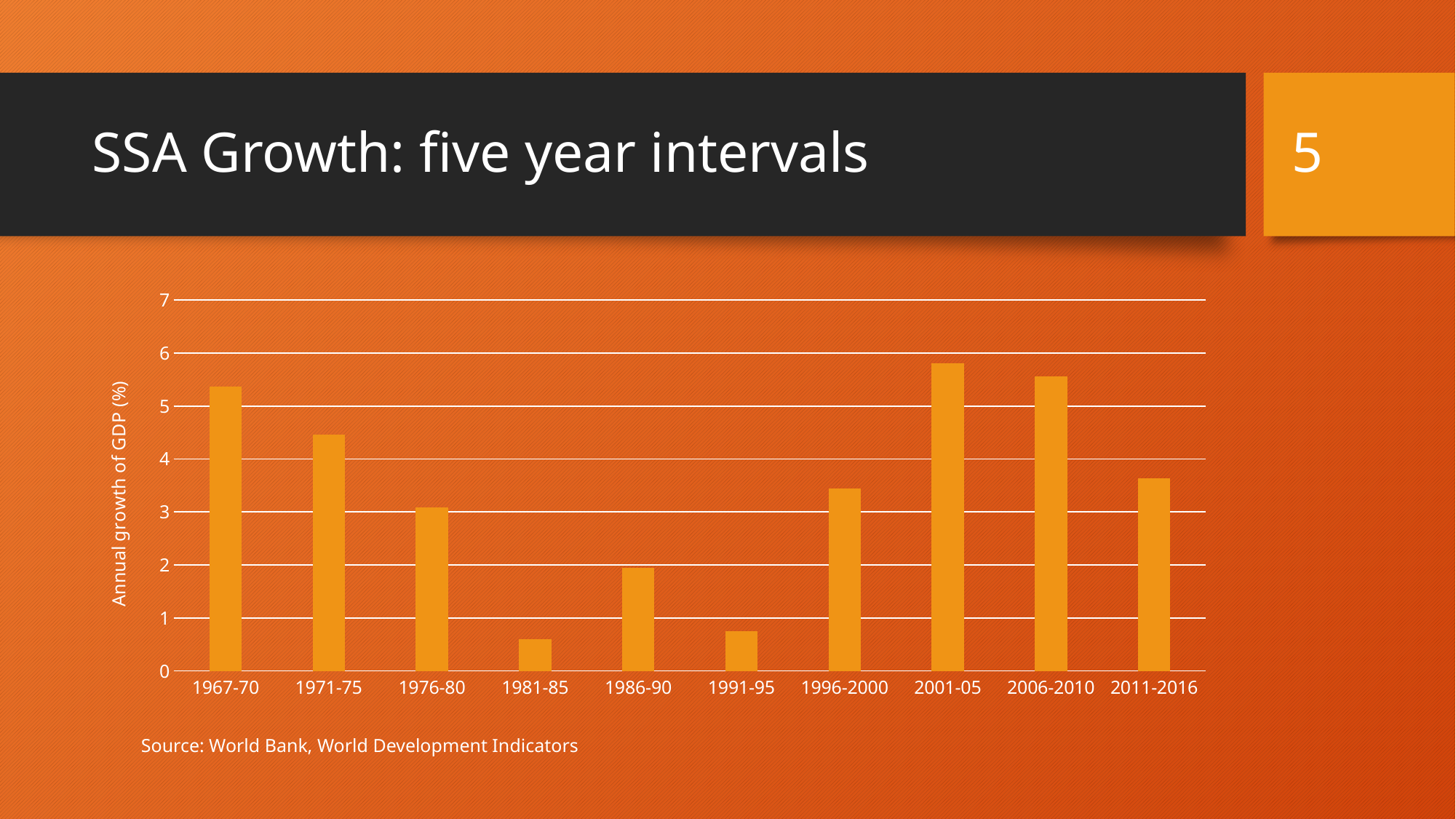
What source is cited below the chart? World Bank, World Development Indicators Is the value for 1971-75 greater or less than 4? greater What is the label on the vertical axis of the chart? Annual growth of GDP (%) Is the value for 1967-70 greater or less than 5? greater Is the value for 2011-2016 greater or less than 4? less Which interval has the highest annual GDP growth? 2001-05 How many five-year intervals (categories) are plotted on the chart? 10 What kind of chart is shown on the slide? Bar chart Which has the higher annual GDP growth, 1986-90 or 1991-95? 1986-90 Which has the higher annual GDP growth, 1967-70 or 1971-75? 1967-70